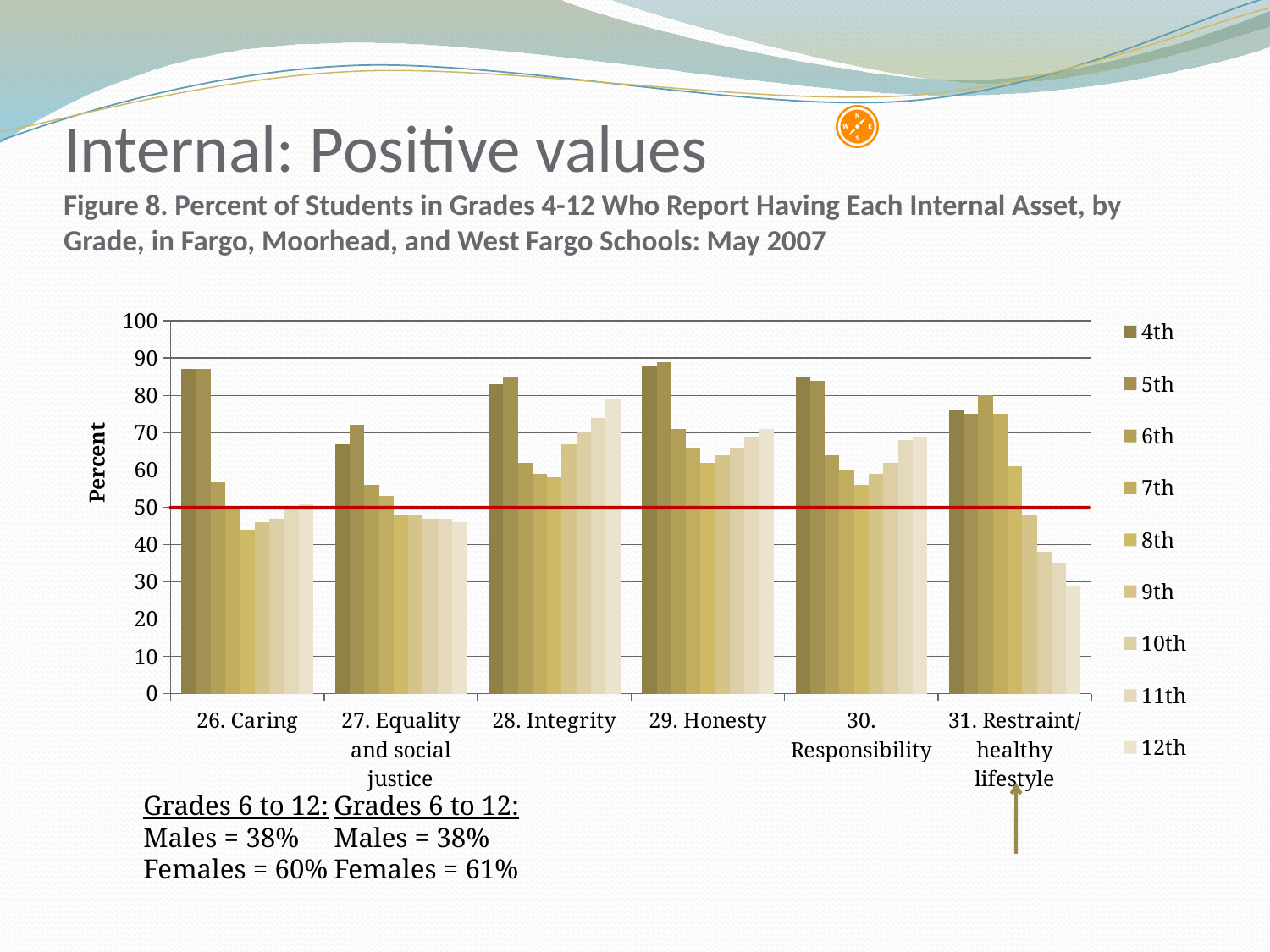
How many asset categories are shown along the x axis of the chart? 6 In 26. Caring, which is larger: the value for 4th grade or the value for 12th grade? 4th grade Which asset category has the lowest value for 12th grade? 31. Restraint/healthy lifestyle Is the value for 12th grade in 31. Restraint/healthy lifestyle greater or less than 40? less How many grade series does the chart legend list? 9 In 28. Integrity, which is larger: the value for 8th grade or the value for 12th grade? 12th grade Is the value for 11th grade in 27. Equality and social justice greater or less than 50? less What is the label on the vertical axis of the chart? Percent In 31. Restraint/healthy lifestyle, do the values generally rise or fall from 4th grade to 12th grade? fall What kind of chart is shown on the slide? bar chart Is the value for 12th grade in 28. Integrity greater or less than 70? greater